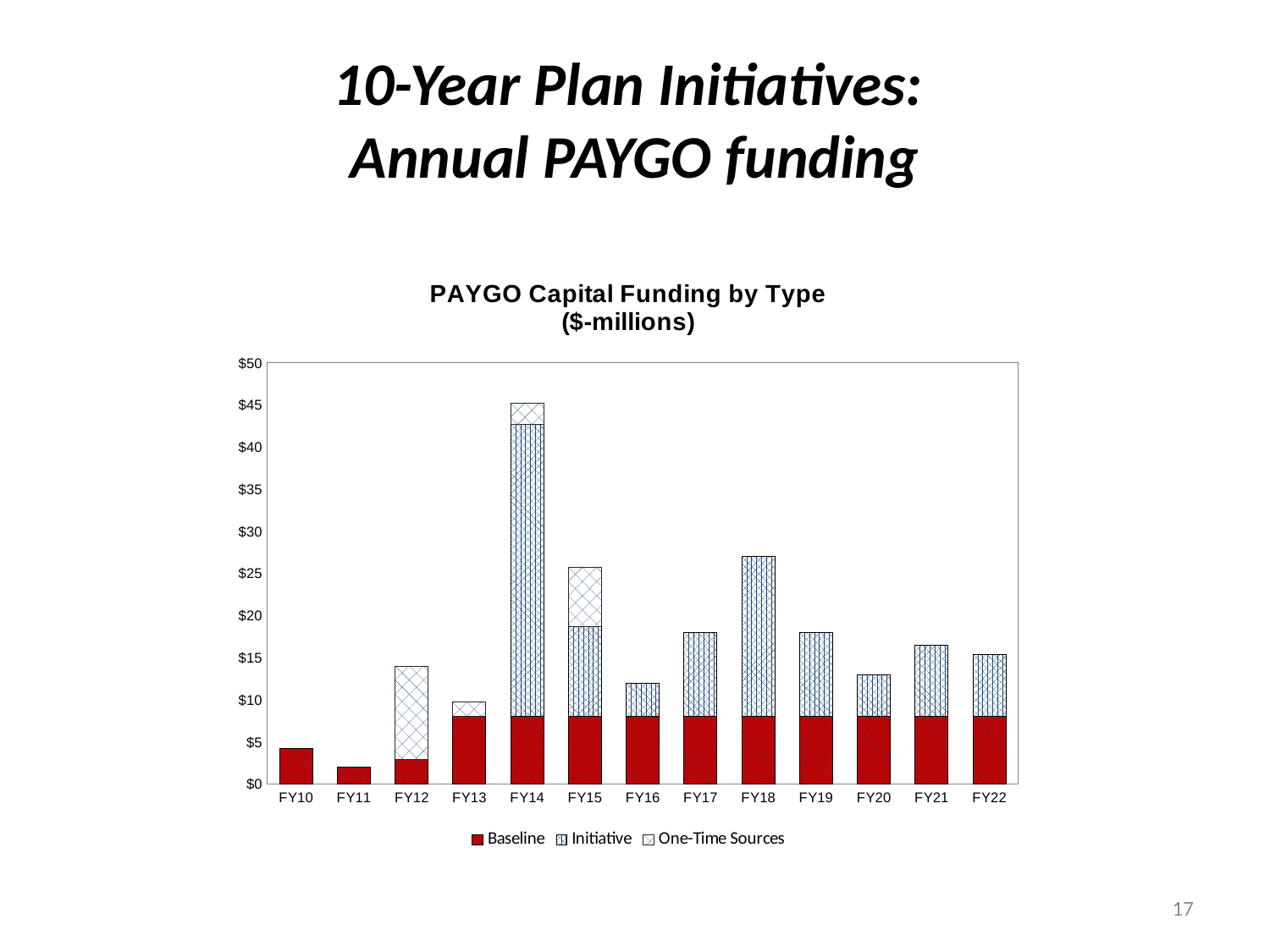
Is the total funding for FY16 greater or less than $10? greater Which fiscal year has the lowest total PAYGO capital funding? FY11 Is the total funding for FY14 greater or less than $40? greater What kind of chart is shown on the slide? Stacked bar chart How many series does the chart's legend list? 3 What is the title of the chart? PAYGO Capital Funding by Type ($-millions) Is the total funding for FY13 greater or less than $15? less Which fiscal year has the highest total PAYGO capital funding? FY14 How many fiscal years are shown on the x axis of the chart? 13 Which has the larger total funding, FY14 or FY18? FY14 Which has the larger total funding, FY16 or FY21? FY21